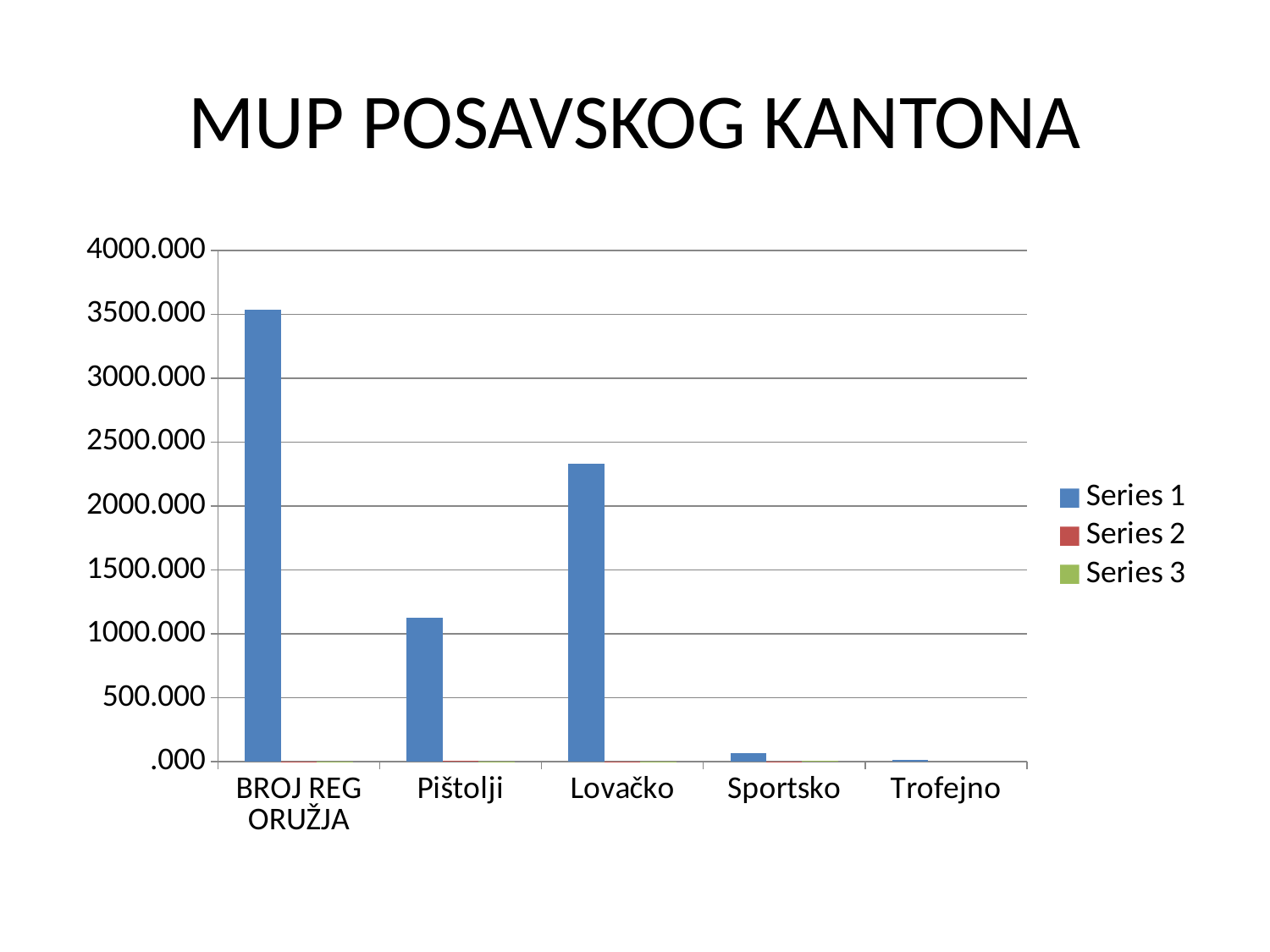
Which category has the lowest Series 1 value? Trofejno Which has a larger Series 1 value, Lovačko or Pištolji? Lovačko Is the Series 1 value for Lovačko greater or less than 2500.000? less Which has a larger Series 1 value, Sportsko or Trofejno? Sportsko Is the Series 1 value for Sportsko greater or less than 500.000? less Which category has the highest Series 1 value? BROJ REG ORUŽJA What is the title of the slide? MUP POSAVSKOG KANTONA How many categories are shown on the x axis of the chart? 5 What kind of chart is shown on the slide? bar chart Is the Series 1 value for Pištolji greater or less than 1000.000? greater How many series does the legend list? 3